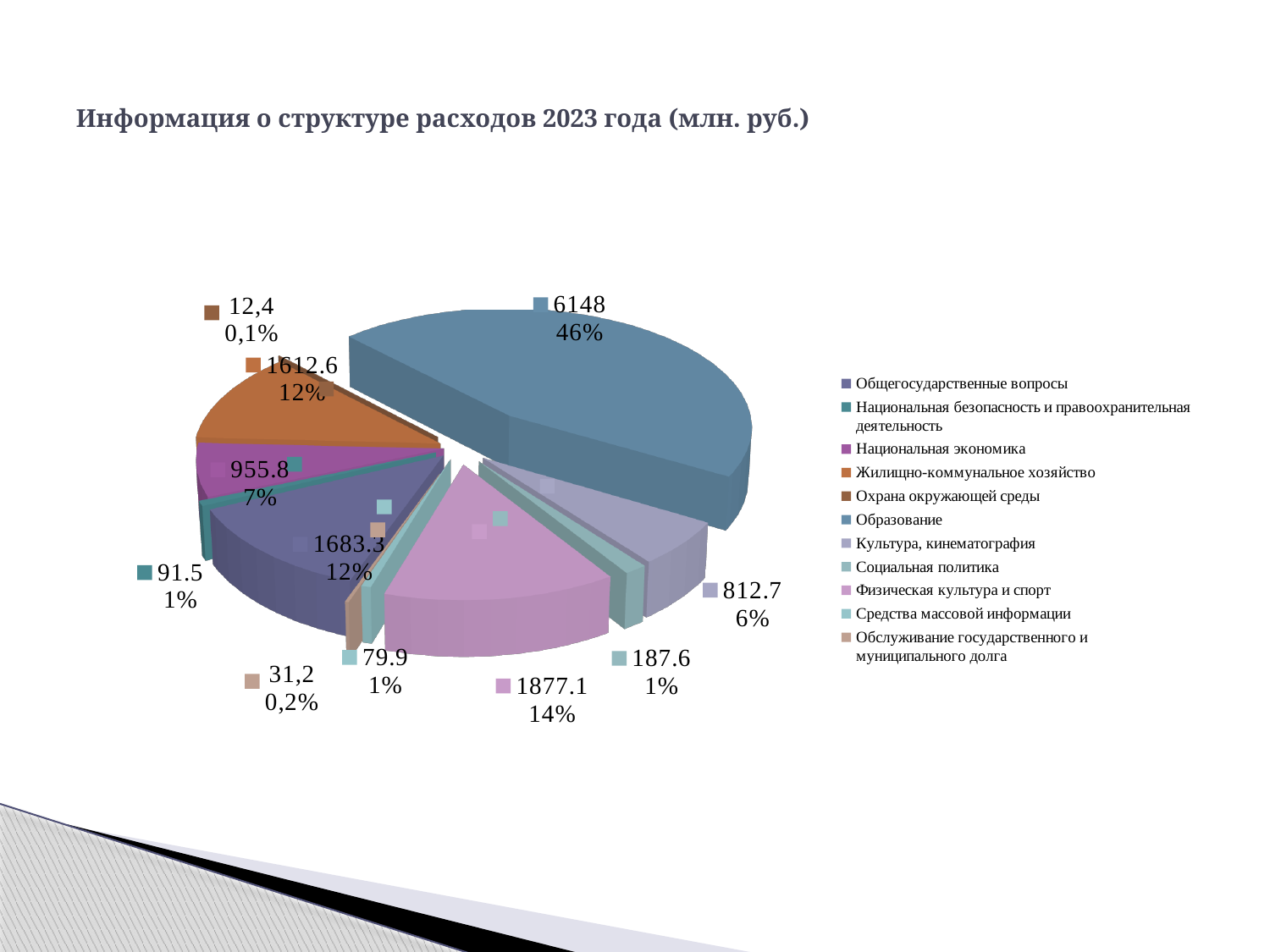
How many slices does the pie chart have? 11 How many entries does the legend list? 11 Which category has the largest slice? Образование Which category has the smallest slice? Охрана окружающей среды What kind of chart is shown on the slide? Pie chart What share of the pie does Физическая культура и спорт take? 14% Which is larger, Физическая культура и спорт or Общегосударственные вопросы? Физическая культура и спорт What share of the pie does Образование take? 46% What is the value for Жилищно-коммунальное хозяйство? 1612.6 What is the title of the chart? Информация о структуре расходов 2023 года (млн. руб.) What is the value for Образование? 6148 What is the difference between the values for Образование and Физическая культура и спорт? 4270.9